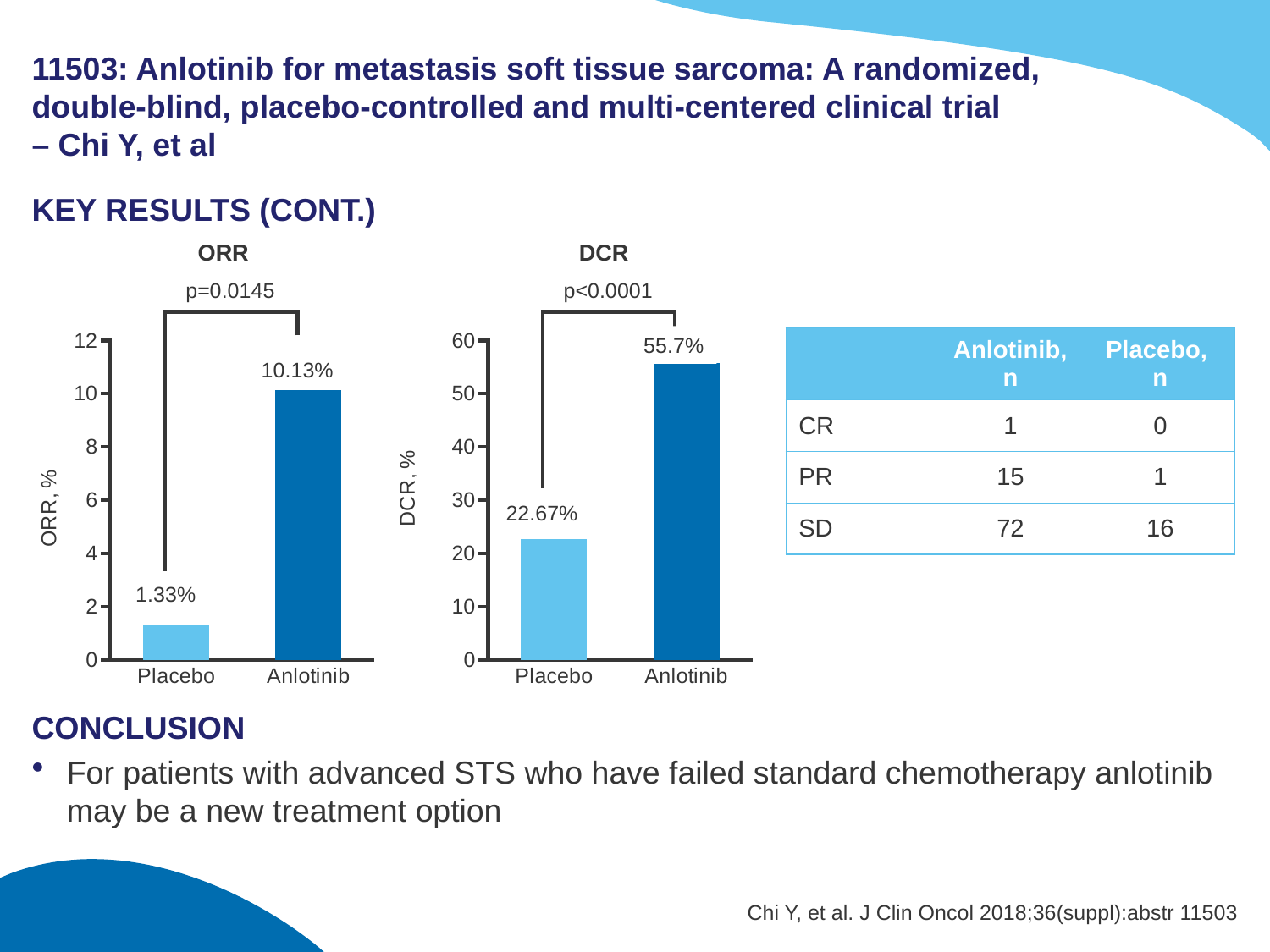
What p-value is shown above the ORR chart? p=0.0145 How many categories are shown on the x axis of the ORR chart? 2 In the DCR chart, which group has the lower value? Placebo What kind of chart is the DCR chart? Bar chart In the DCR chart, what is the difference between the Anlotinib and Placebo values? 33.03% In the ORR chart, which group has the higher value? Anlotinib In the DCR chart, what is the value for Placebo? 22.67% In the DCR chart, is the value for Anlotinib greater or less than 50? greater In the ORR chart, what is the difference between the Anlotinib and Placebo values? 8.80% In the ORR chart, what is the value for Anlotinib? 10.13% In the DCR chart, what is the value for Anlotinib? 55.7% In the ORR chart, what is the value for Placebo? 1.33%